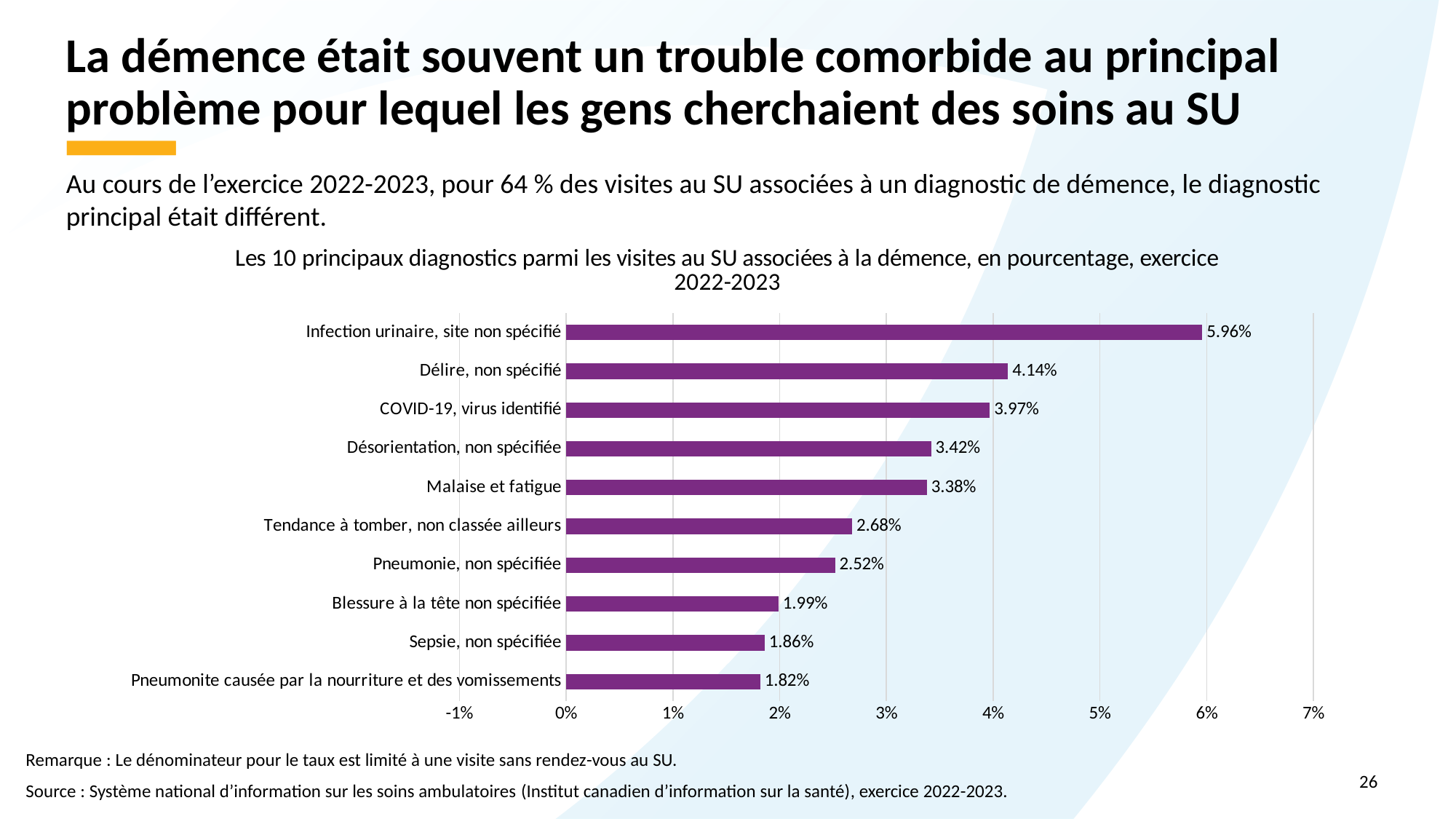
What kind of chart is shown on the slide? Bar chart Is the value for Blessure à la tête non spécifiée greater or less than 2%? less What is the value for COVID-19, virus identifié? 3.97% Which diagnosis has the highest percentage? Infection urinaire, site non spécifié What is the value for Sepsie, non spécifiée? 1.86% What is the value for Infection urinaire, site non spécifié? 5.96% What is the difference between Délire, non spécifié and COVID-19, virus identifié? 0.17% What is the title of the chart? Les 10 principaux diagnostics parmi les visites au SU associées à la démence, en pourcentage, exercice 2022-2023 Which diagnosis has the lowest percentage? Pneumonite causée par la nourriture et des vomissements What is the difference between Infection urinaire, site non spécifié and Pneumonite causée par la nourriture et des vomissements? 4.14% Which is larger, Tendance à tomber, non classée ailleurs or Pneumonie, non spécifiée? Tendance à tomber, non classée ailleurs How many diagnoses are shown in the chart? 10